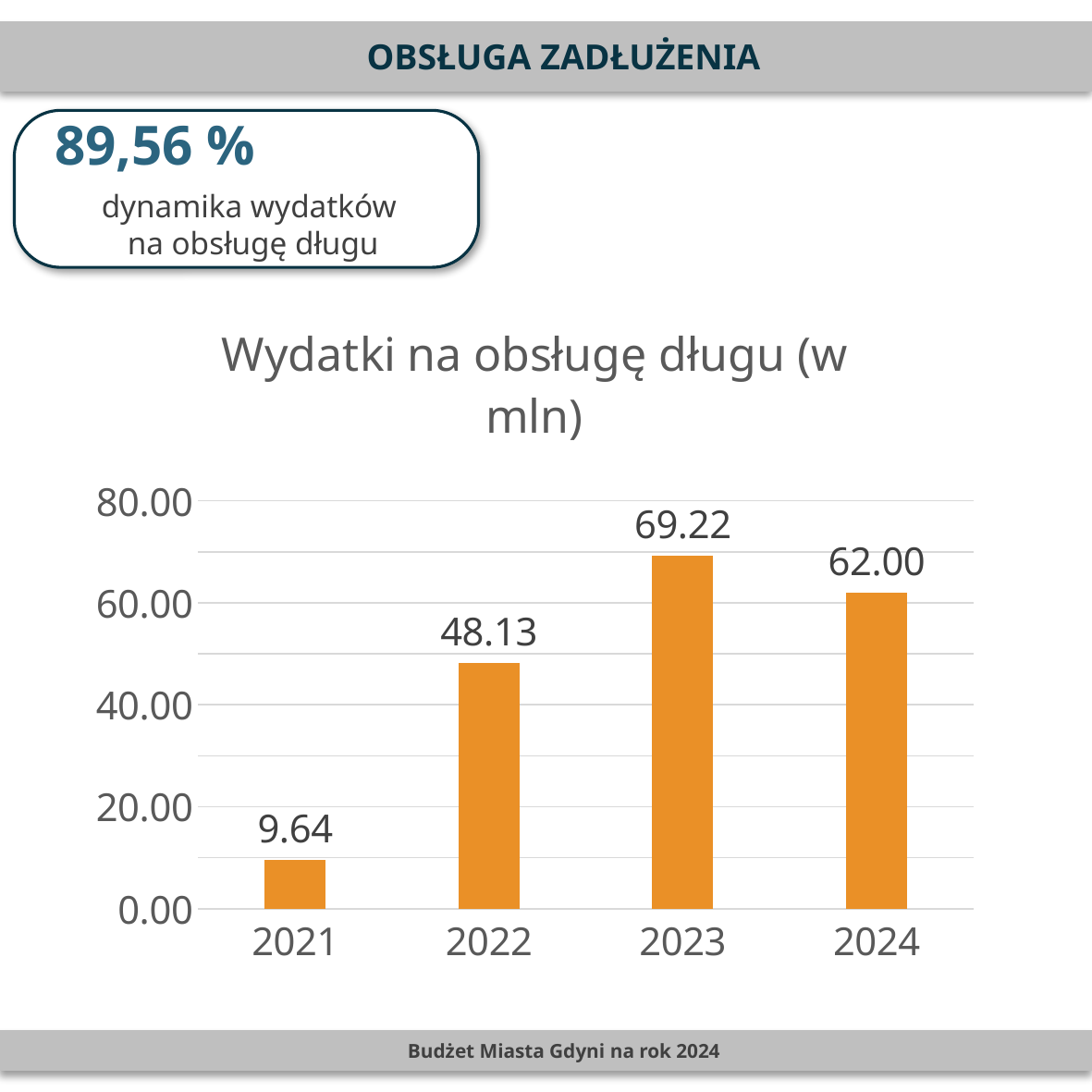
Is the value for 2022 greater or less than 40.00? greater What is the value for 2024? 62.00 What kind of chart is shown? bar chart Which year has the highest value? 2023 What is the title of the chart? Wydatki na obsługę długu (w mln) How many years are shown on the x axis? 4 What is the difference between the values for 2023 and 2024? 7.22 Which is larger, the value for 2022 or the value for 2024? 2024 What is the value for 2023? 69.22 What is the value for 2021? 9.64 Which year has the lowest value? 2021 What is the value for 2022? 48.13